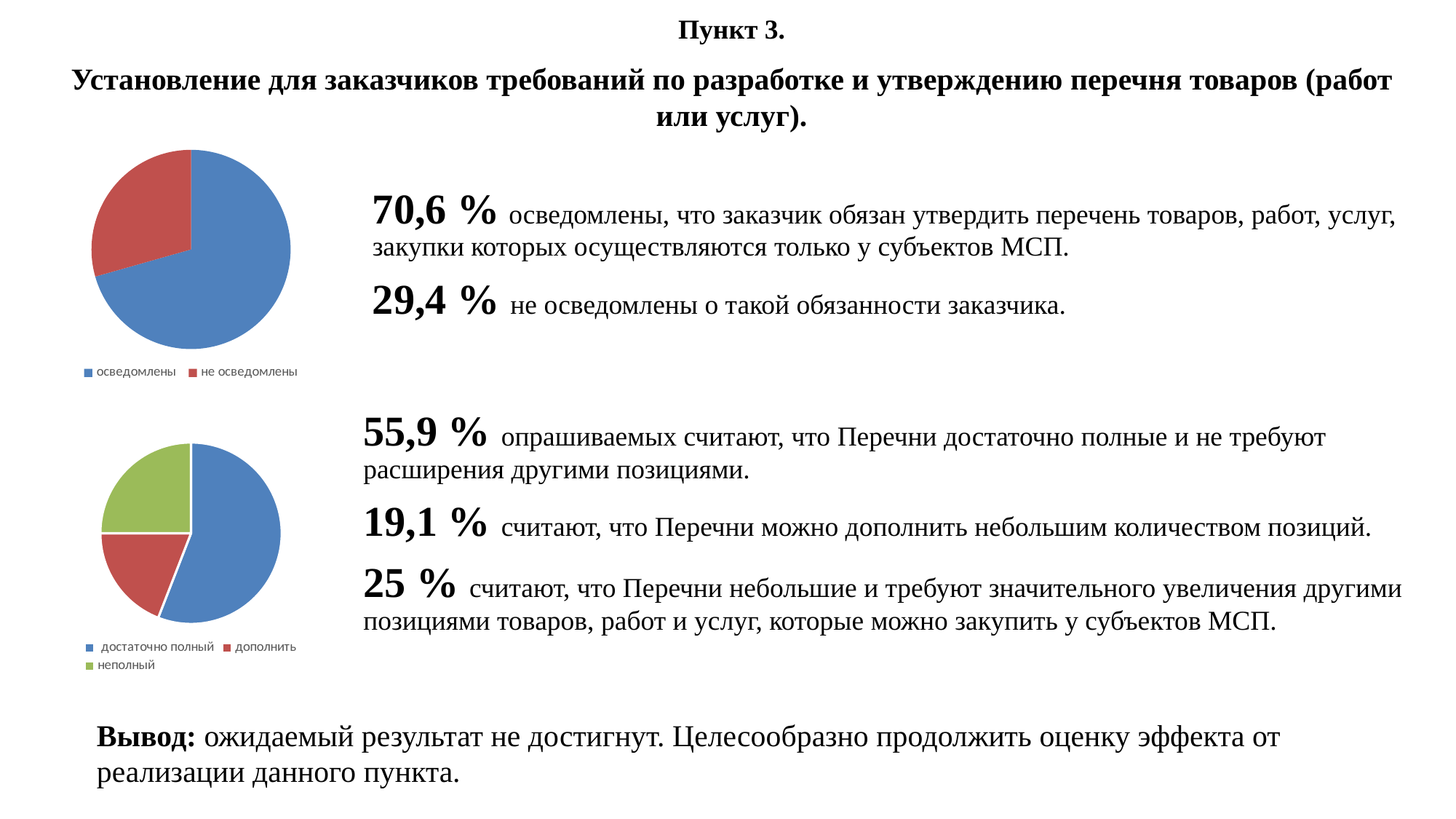
How many slices does the top pie chart have? 2 In the bottom pie chart, what colour is the 'неполный' slice? green In the bottom pie chart, which slice is larger: 'неполный' or 'дополнить'? неполный In the bottom pie chart, what share corresponds to 'неполный'? 25 % In the bottom pie chart, what share corresponds to 'достаточно полный'? 55,9 % In the top pie chart, which category has the largest slice? осведомлены In the top pie chart, what share of respondents are 'не осведомлены'? 29,4 % How many slices does the bottom pie chart have? 3 In the bottom pie chart, which category has the smallest slice? дополнить What kind of chart is the top chart on the slide? pie chart